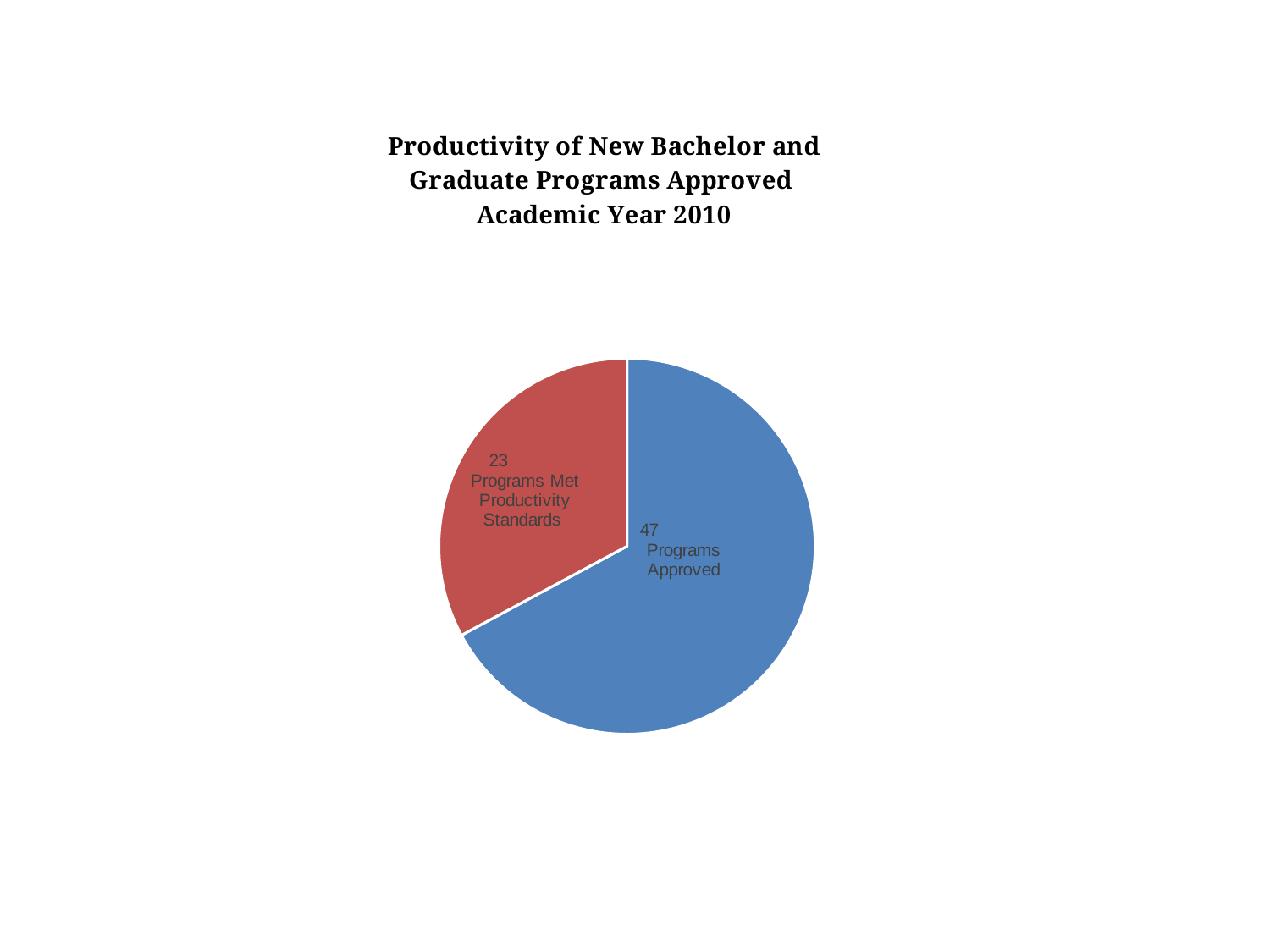
What kind of chart is shown on the slide? Pie chart Which slice of the pie chart is the largest? Programs Approved Which slice of the pie chart is the smallest? Programs Met Productivity Standards What is the total of the two values shown in the pie chart? 70 What colour is the slice for Programs Met Productivity Standards? Red How many slices does the pie chart have? 2 What is the difference between the number of programs approved and the number of programs that met productivity standards? 24 What is the title of the chart? Productivity of New Bachelor and Graduate Programs Approved Academic Year 2010 How many programs met productivity standards according to the pie chart? 23 Which is larger: the number of programs approved or the number of programs that met productivity standards? Programs Approved How many programs were approved according to the pie chart? 47